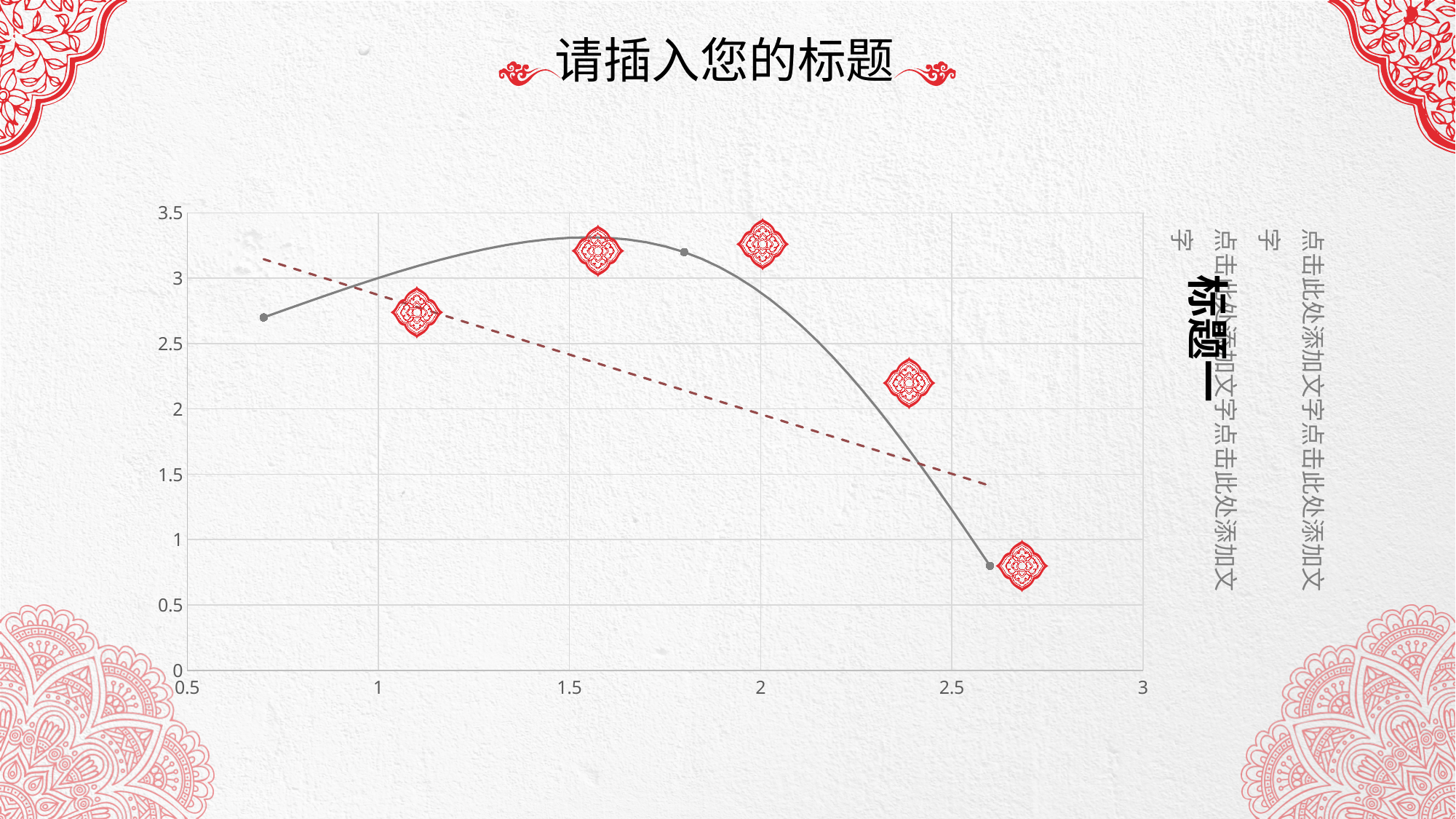
Does the dashed trend line rise or fall from left to right? falls What is the title of the slide above the chart? 请插入您的标题 Does the solid curve rise or fall between x = 2 and x = 2.5? falls Which point has the larger y value: the leftmost point near x = 0.7 or the rightmost point near x = 2.7? the leftmost point near x = 0.7 What kind of chart is shown on the slide? scatter chart Is the y value of the leftmost point (near x = 0.7) greater or less than 2.5? greater What is the highest value shown on the vertical axis of the chart? 3.5 Is the y value of the rightmost point (near x = 2.7) greater or less than 1? less